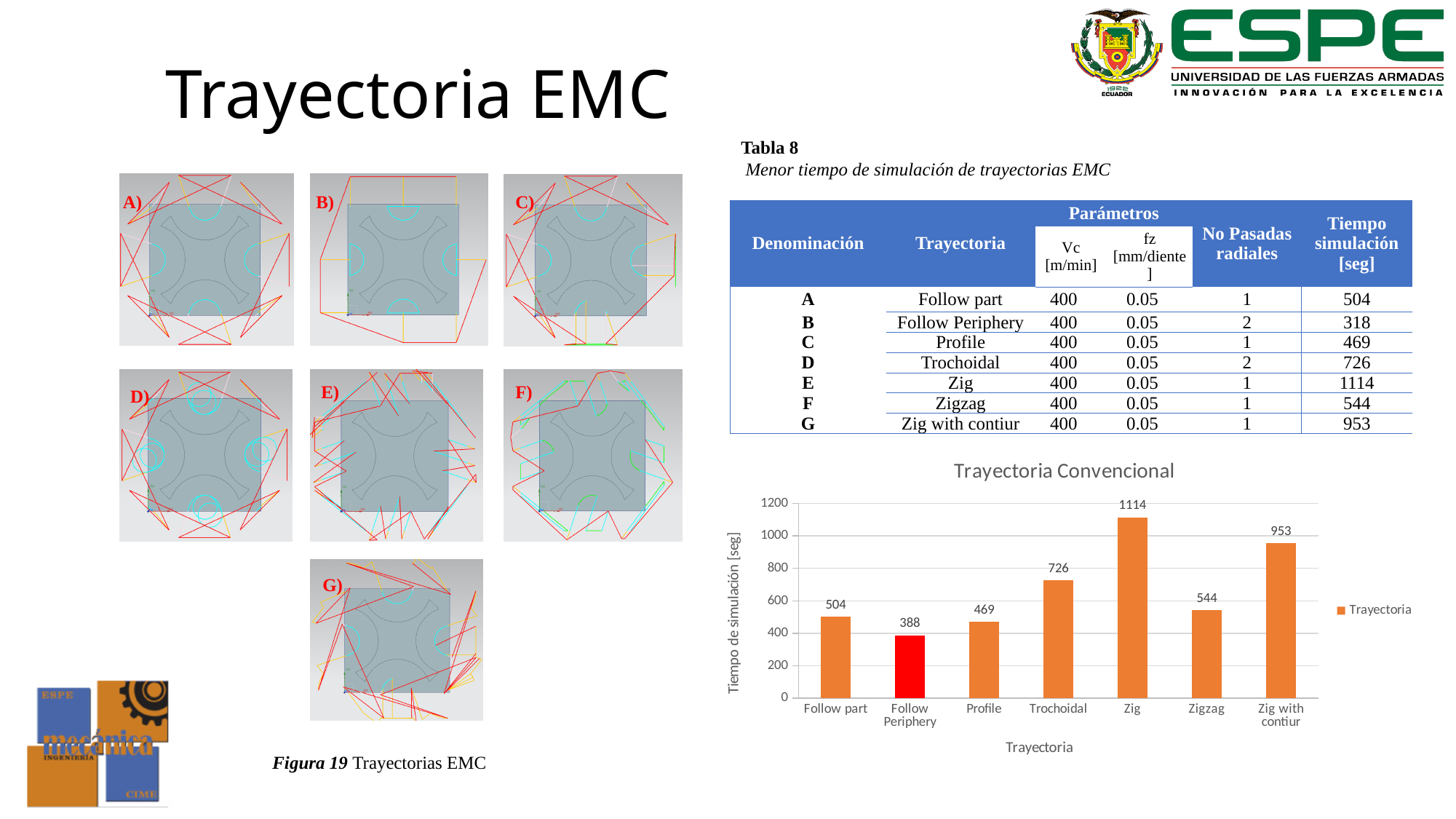
Which has a larger simulation time, Follow part or Zigzag? Zigzag What is the difference between the simulation times of Zig and Zig with contiur? 161 What is the simulation time for Zig in the chart? 1114 Which trajectory has the highest simulation time in the chart? Zig Which trajectory has the lowest simulation time in the chart? Follow Periphery Is the value for Profile greater or less than 600? less What type of chart is shown on the slide? bar chart What is the chart's title? Trayectoria Convencional What is the simulation time for Trochoidal in the chart? 726 What value does the chart show for Follow Periphery? 388 How many series does the chart legend list? 1 How many trajectories are plotted on the x axis of the chart? 7